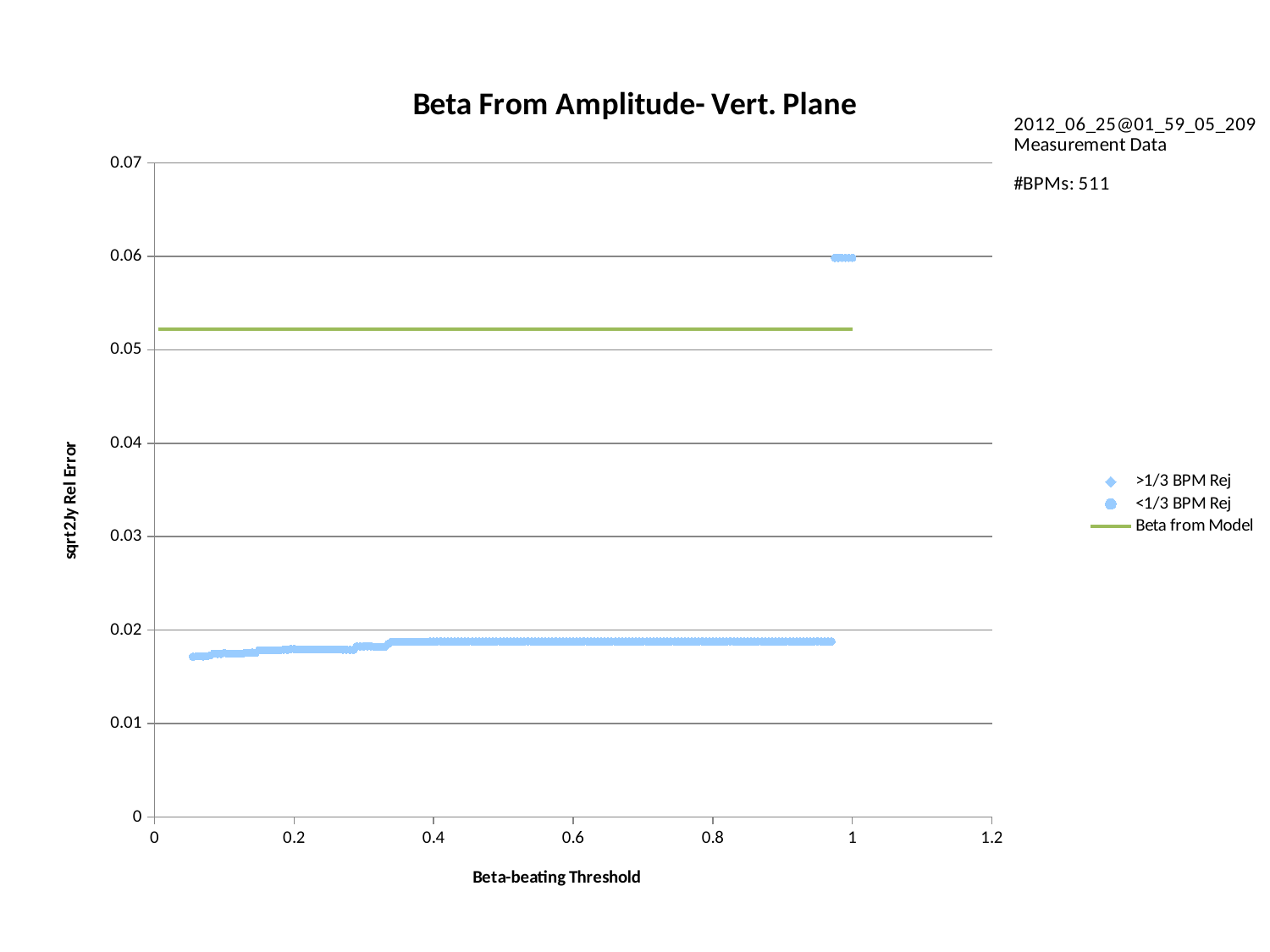
Is the value of the Beta from Model line greater or less than 0.05? greater Is the value of the Beta from Model line greater or less than 0.06? less How many series does the legend list? 3 What kind of chart is shown on the slide? scatter chart Are the values of the >1/3 BPM Rej series greater or less than 0.05? less What is the title of the chart? Beta From Amplitude- Vert. Plane Do the <1/3 BPM Rej values rise or fall as the Beta-beating Threshold increases? rise Which is higher on the chart, the >1/3 BPM Rej points or the Beta from Model line? Beta from Model What is the label of the x axis? Beta-beating Threshold